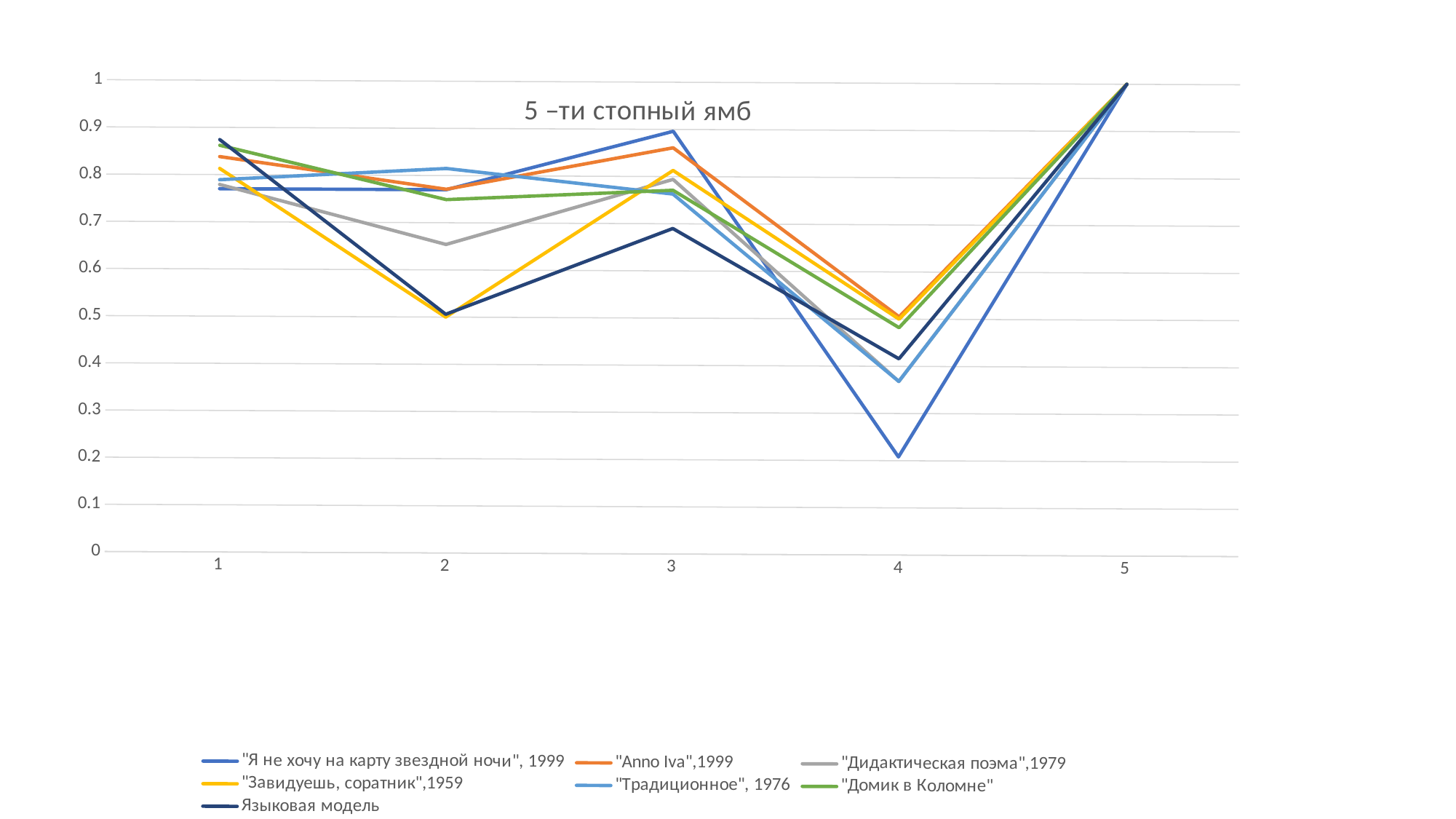
What is the title of the chart? 5 –ти стопный ямб Which series has the highest value at x = 3? "Я не хочу на карту звездной ночи", 1999 How many series does the legend list? 7 Is the value for Языковая модель at x = 2 greater or less than 0.6? less What kind of chart is shown on the slide? line chart Is the value for "Anno Iva",1999 at x = 3 greater or less than 0.8? greater How many points are there along the x axis? 5 Is the value for "Я не хочу на карту звездной ночи", 1999 at x = 4 greater or less than 0.3? less Do the series rise or fall from x = 4 to x = 5? rise At x = 2, which is larger: Языковая модель or "Традиционное", 1976? "Традиционное", 1976 Which series has the lowest value at x = 4? "Я не хочу на карту звездной ночи", 1999